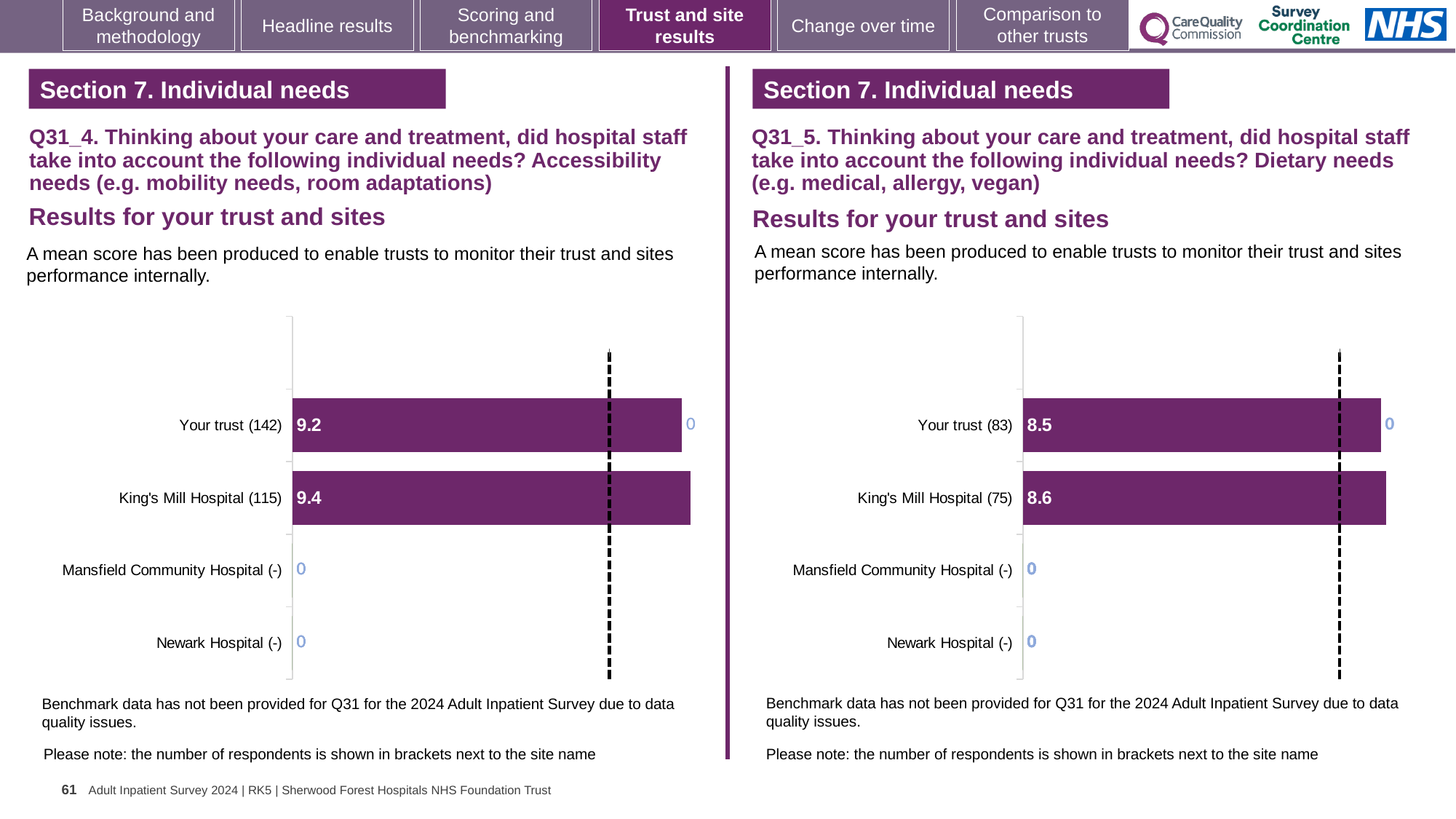
In the right chart (Q31_5, Dietary needs), what is the difference between the King's Mill Hospital score and the Your trust score? 0.1 In the left chart (Q31_4, Accessibility needs), what is the mean score for Your trust (142)? 9.2 In the right chart (Q31_5, Dietary needs), how many respondents are shown in brackets for Your trust? 83 In the left chart (Q31_4, Accessibility needs), how many respondents are shown in brackets for King's Mill Hospital? 115 In the right chart (Q31_5, Dietary needs), what is the mean score for Your trust (83)? 8.5 In the right chart (Q31_5, Dietary needs), what is the mean score for King's Mill Hospital (75)? 8.6 In the left chart (Q31_4, Accessibility needs), which is higher: the score for Your trust or for King's Mill Hospital? King's Mill Hospital In the right chart (Q31_5, Dietary needs), which is higher: the score for Your trust or for King's Mill Hospital? King's Mill Hospital In the left chart (Q31_4, Accessibility needs), what is the difference between the King's Mill Hospital score and the Your trust score? 0.2 What type of chart is used in the right chart (Q31_5, Dietary needs)? Bar chart How many categories (sites) are listed on the y axis of the left chart (Q31_4, Accessibility needs)? 4 In the left chart (Q31_4, Accessibility needs), what is the mean score for King's Mill Hospital (115)? 9.4